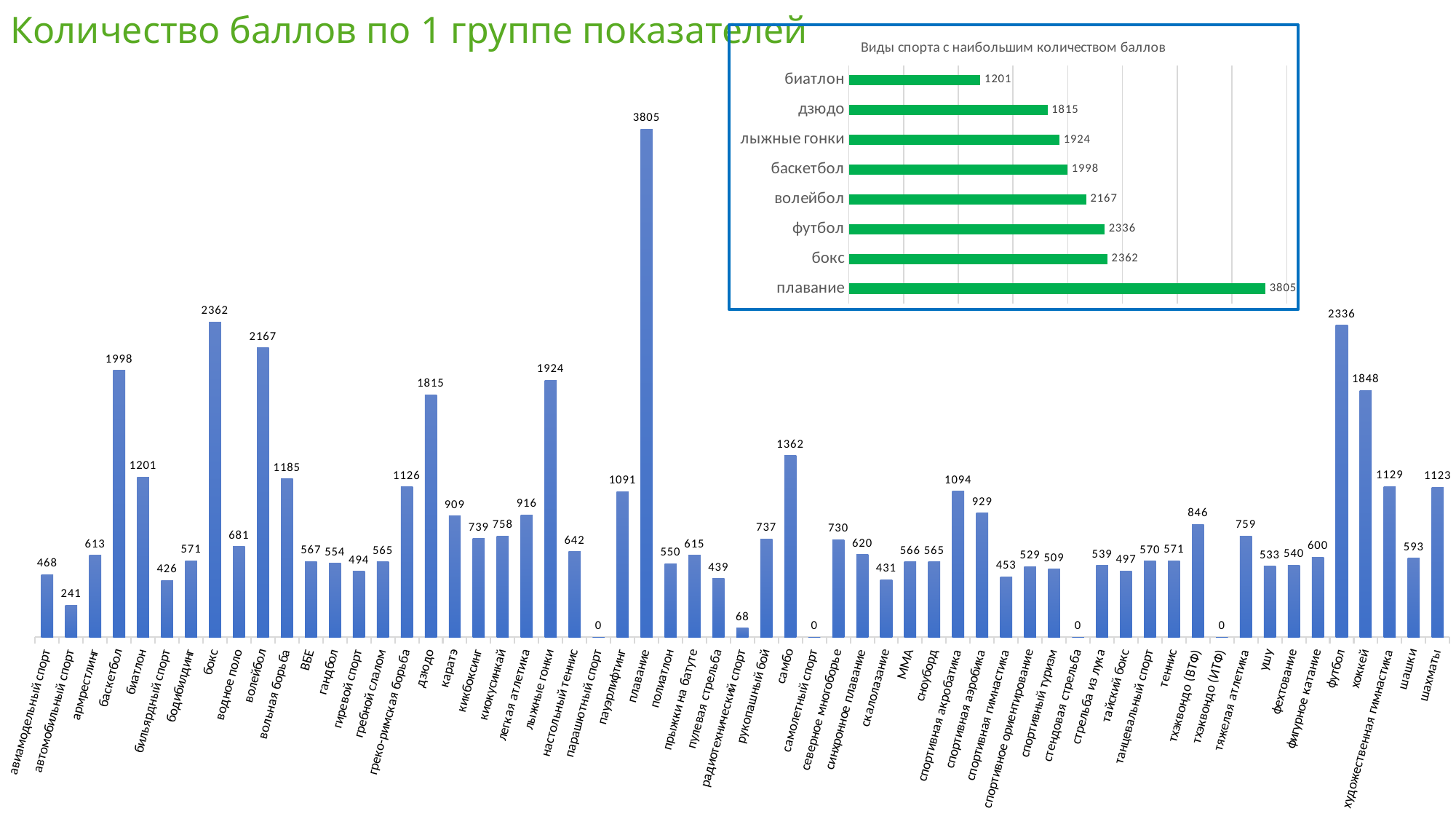
In the inset chart 'Виды спорта с наибольшим количеством баллов', which sport has the lowest value? биатлон In the large bar chart, which sport has the highest value? плавание In the large bar chart, what is the value for самбо? 1362 In the large bar chart, what is the value for хоккей? 1848 What is the title of the inset chart in the top right? Виды спорта с наибольшим количеством баллов In the inset chart 'Виды спорта с наибольшим количеством баллов', how many sports are listed? 8 In the large bar chart, what is the difference between футбол and хоккей? 488 In the inset chart 'Виды спорта с наибольшим количеством баллов', what is the difference between бокс and футбол? 26 In the inset chart 'Виды спорта с наибольшим количеством баллов', what is the value for плавание? 3805 In the large bar chart, which is larger: волейбол or баскетбол? волейбол In the inset chart 'Виды спорта с наибольшим количеством баллов', what type of chart is shown? bar chart In the large bar chart, what is the value for автомобильный спорт? 241